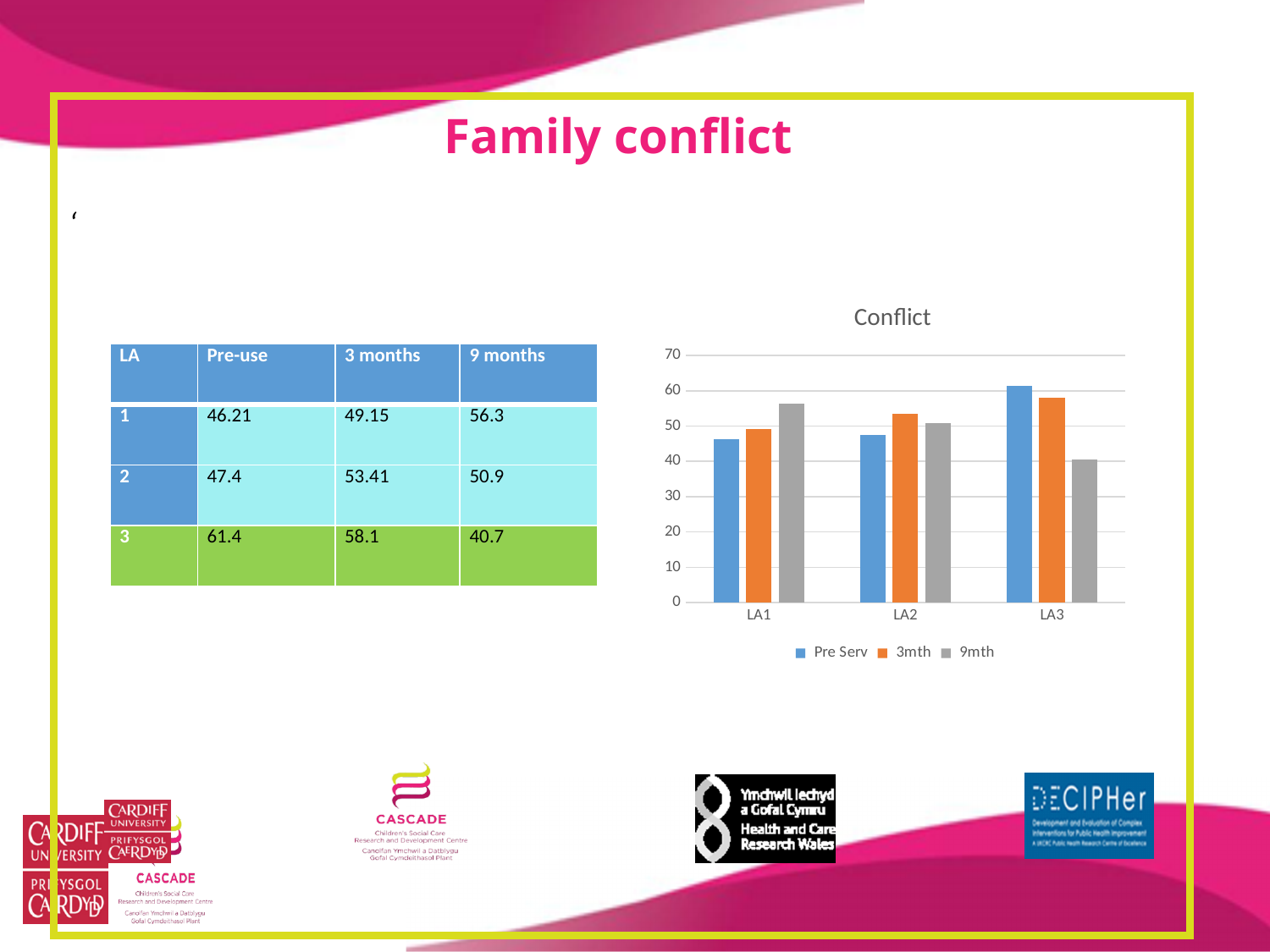
Is the 9mth value for LA3 greater or less than 50? less How many series does the chart's legend list? 3 Which series has the lowest bar for LA3? 9mth How many categories are shown on the x axis of the chart? 3 What kind of chart is shown on the slide? bar chart For LA3, which is larger: the Pre Serv bar or the 9mth bar? Pre Serv For LA1, do the values rise or fall from Pre Serv to 9mth? rise Which category has the tallest bar in the chart? LA3 What is the title of the chart? Conflict According to the table on the slide, what is the Pre-use value for LA 1? 46.21 What are the series names listed in the chart's legend? Pre Serv, 3mth, 9mth Is the 9mth value for LA1 greater or less than 50? greater